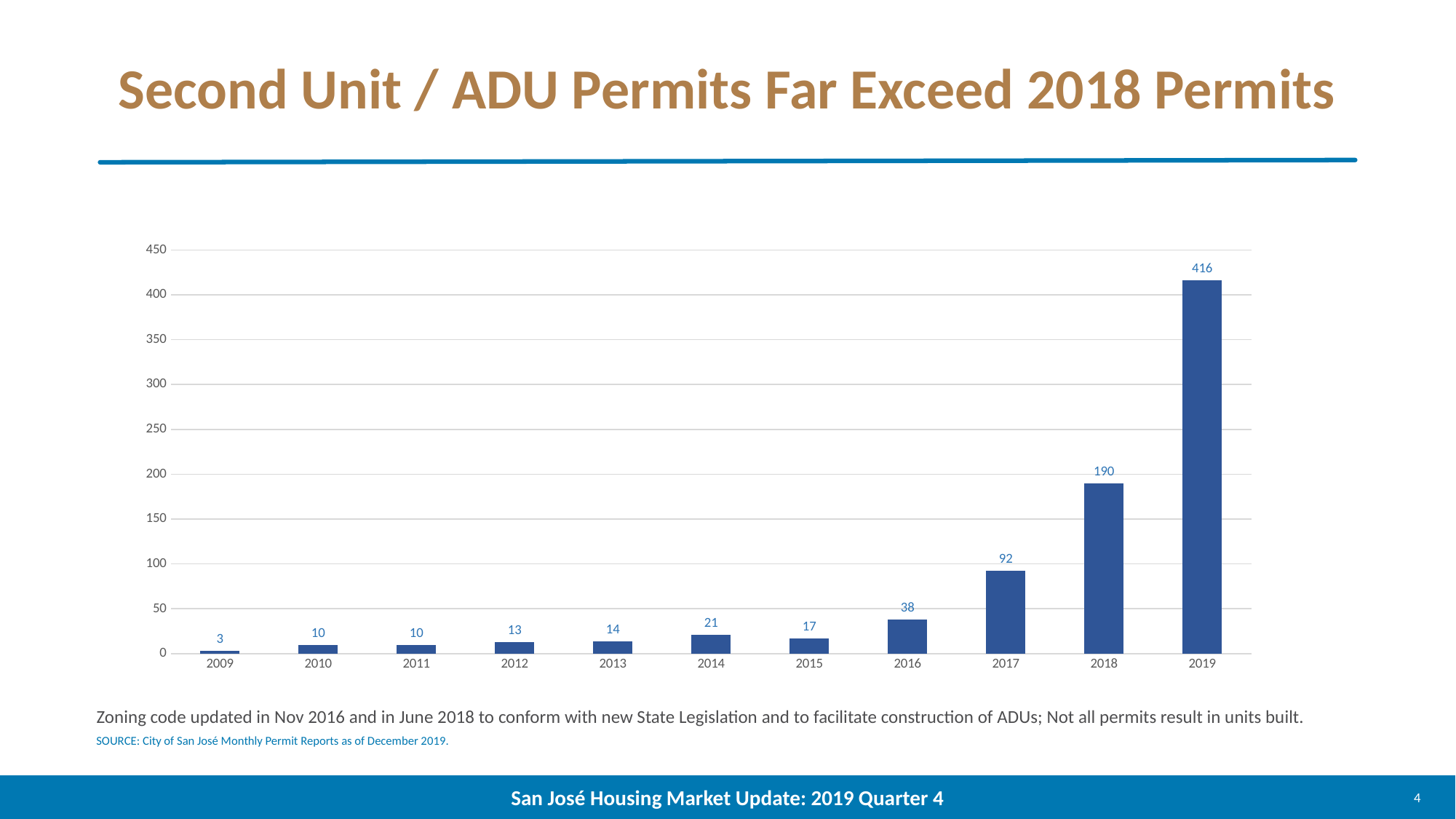
How many years are shown on the x axis? 11 Which is larger, the value for 2015 or the value for 2014? 2014 Which year has the lowest value? 2009 What is the value for 2018? 190 What kind of chart is shown on the slide? bar chart What is the value for 2019? 416 What is the value for 2014? 21 What is the difference between the values for 2017 and 2016? 54 Which year has the highest value? 2019 What is the difference between the values for 2019 and 2018? 226 Do the values generally rise or fall from 2016 to 2019? rise Is the value for 2017 greater or less than 100? less